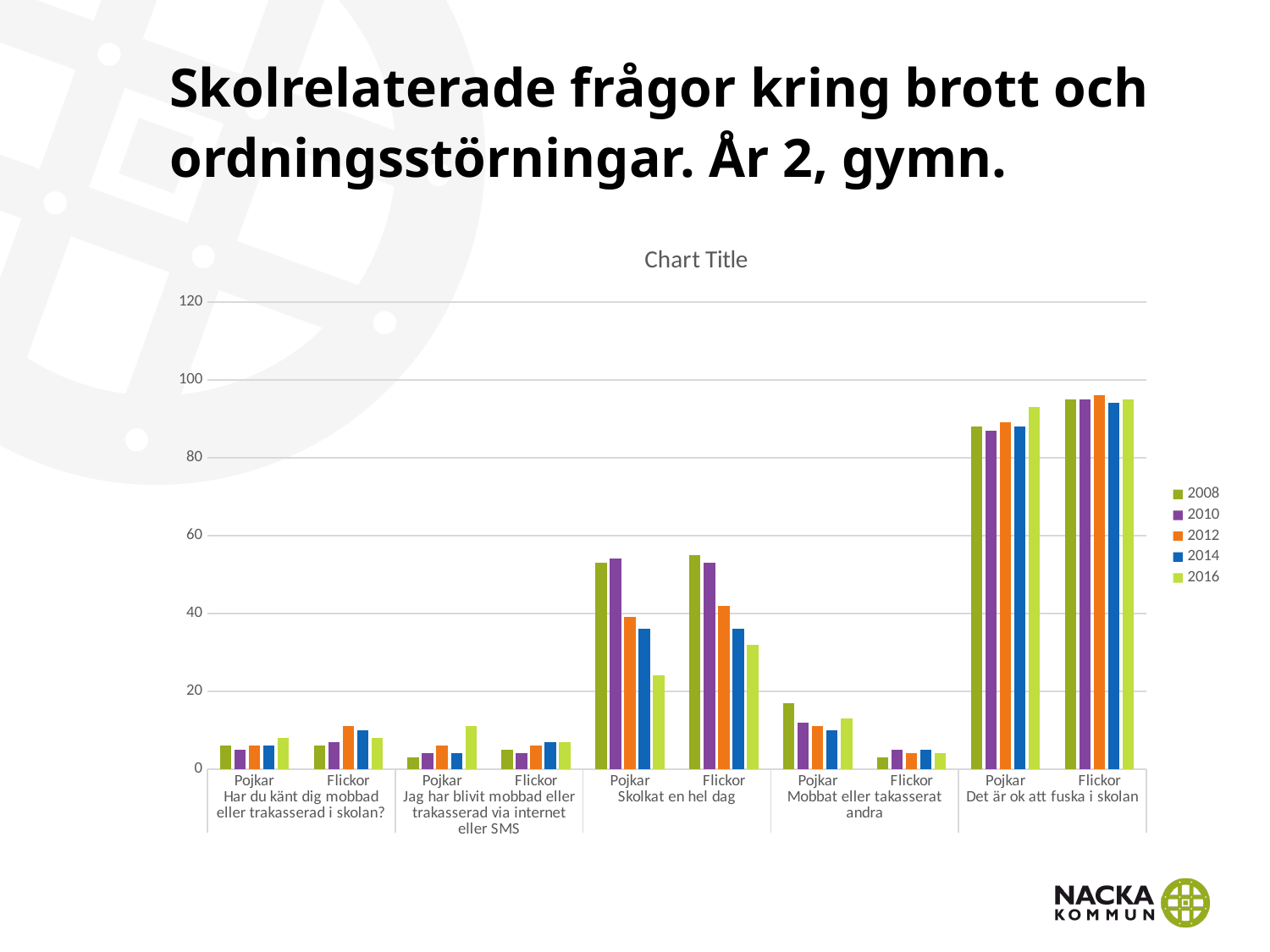
Under 'Mobbat eller takasserat andra', is the 2008 value larger for Pojkar or Flickor? Pojkar How many question groups are shown along the x axis? 5 How many series does the legend list? 5 Is the 2016 value for Pojkar under 'Skolkat en hel dag' greater or less than 40? less Do the values for Pojkar under 'Skolkat en hel dag' rise or fall from 2008 to 2016? fall Is the 2012 value for Flickor under 'Det är ok att fuska i skolan' greater or less than 80? greater Is the 2008 value for Pojkar under 'Mobbat eller takasserat andra' greater or less than 20? less Which question group has the highest bars in the chart? Det är ok att fuska i skolan Which years are listed in the legend? 2008, 2010, 2012, 2014, 2016 Under 'Skolkat en hel dag', is the 2016 value larger for Pojkar or Flickor? Flickor What kind of chart is shown on the slide? bar chart